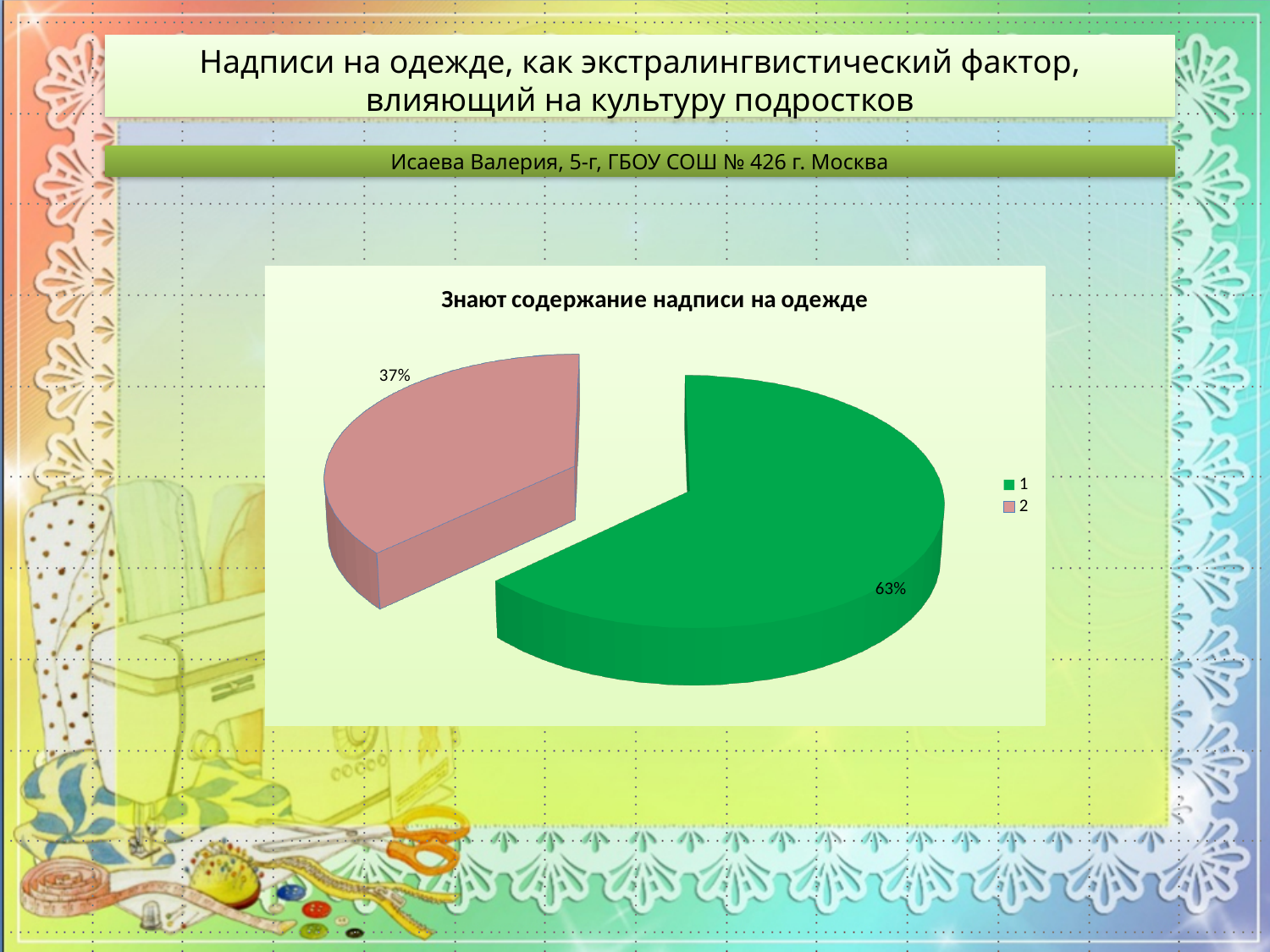
What percentage is shown for category 2? 37% What percentage is shown for category 1? 63% What is the difference in percentage points between category 1 and category 2? 26 What share of the pie does category 2 represent? 37% Which is larger, the slice for category 1 or the slice for category 2? 1 How many slices does the pie chart have? 2 Which category has the largest slice of the pie? 1 Which category has the smallest slice of the pie? 2 What is the title of the chart? Знают содержание надписи на одежде What kind of chart is shown on the slide? Pie chart What colour is the slice for category 1? Green How many entries does the legend list? 2